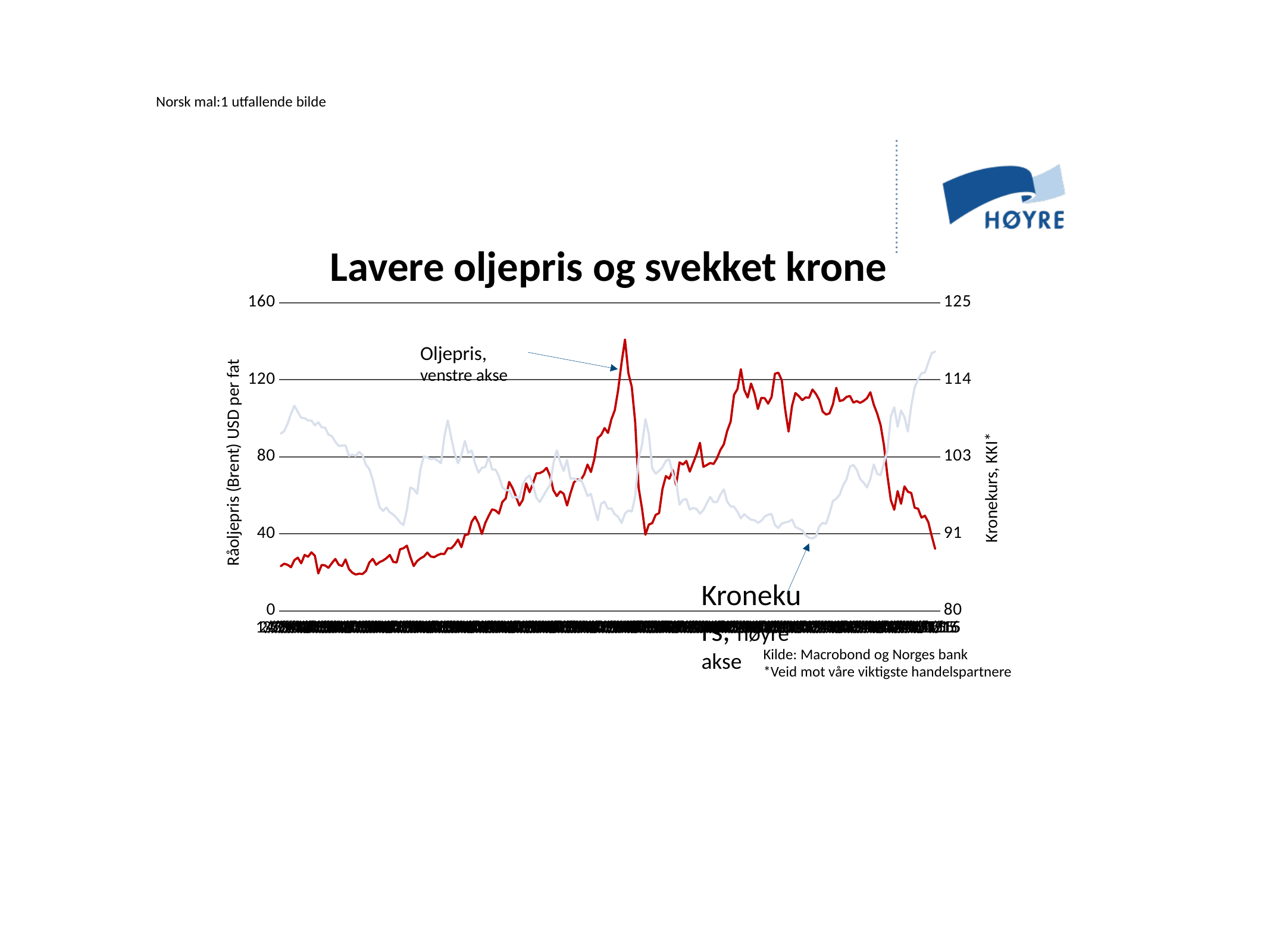
Is the oil price value at the right end of the chart greater or less than 40? less Is the krone exchange rate value at the right end of the chart greater or less than 114 on the right axis? greater What is the highest tick value shown on the right vertical axis? 125 What is the label of the left vertical axis? Råoljepris (Brent) USD per fat What is the highest tick value shown on the left vertical axis? 160 Is the peak value of the oil price line (Oljepris, venstre akse) greater or less than 120? greater What kind of chart is shown on the slide? line chart What is the title of the chart? Lavere oljepris og svekket krone How many data series are plotted in the chart? 2 Does the krone exchange rate line rise or fall over the final stretch at the right end of the chart? rise Does the oil price line rise or fall over the final stretch at the right end of the chart? fall